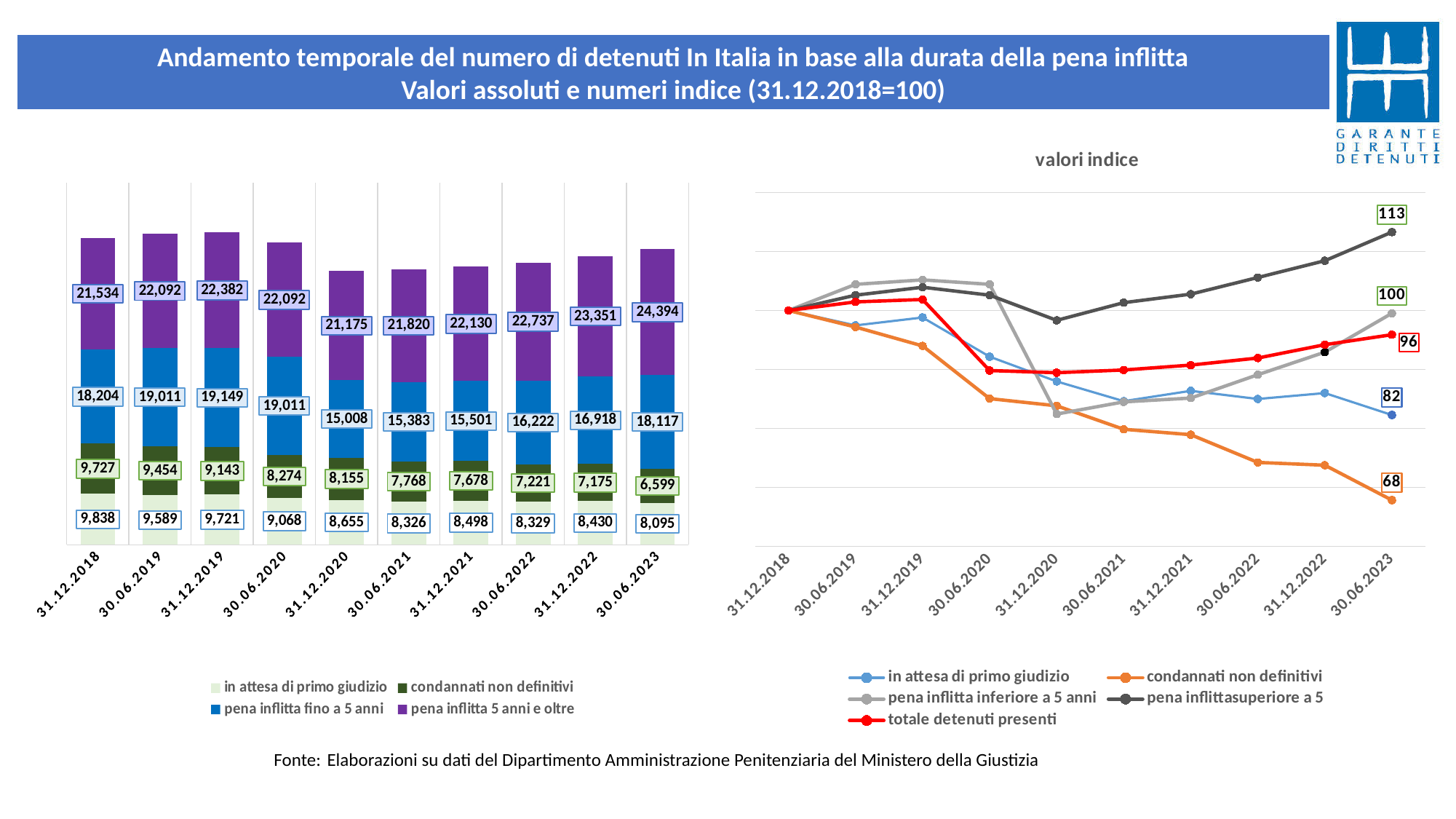
In the 'valori indice' line chart, does the 'condannati non definitivi' series rise or fall from 31.12.2018 to 30.06.2023? fall In the left-hand bar chart, by how much does 'pena inflitta 5 anni e oltre' at 30.06.2023 exceed its value at 31.12.2018? 2,860 What kind of chart is the left-hand chart on the slide? bar chart How many series does the legend of the left-hand bar chart list? 4 In the left-hand bar chart, at which date is the value for 'pena inflitta 5 anni e oltre' highest? 30.06.2023 In the left-hand bar chart, what is the value for 'pena inflitta 5 anni e oltre' at 30.06.2023? 24,394 In the left-hand bar chart, at which date is the value for 'pena inflitta fino a 5 anni' lowest? 31.12.2020 In the 'valori indice' line chart, which series has the highest value at 30.06.2023? pena inflitta superiore a 5 In the 'valori indice' line chart, what is the index value for 'condannati non definitivi' at 30.06.2023? 68 How many dates are shown on the x axis of the left-hand bar chart? 10 In the left-hand bar chart, what is the value for 'pena inflitta fino a 5 anni' at 31.12.2020? 15,008 How many series does the legend of the 'valori indice' line chart list? 5